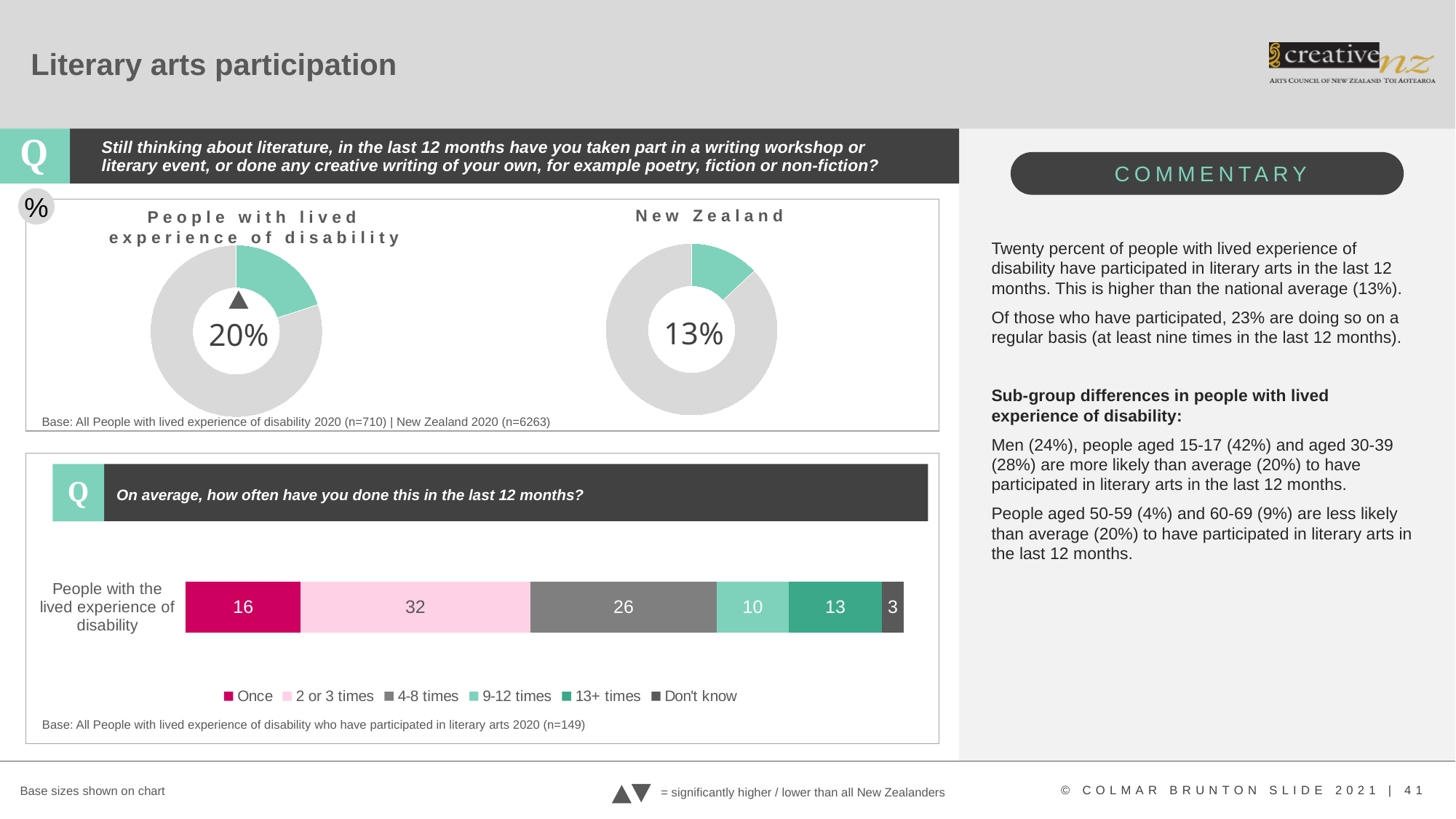
In the bottom stacked bar chart, what is the value for '2 or 3 times'? 32 Comparing the two donut charts at the top, which group has the higher participation value: people with lived experience of disability or New Zealand? People with lived experience of disability In the bottom stacked bar chart, which frequency category has the smallest value? Don't know In the top-left donut chart, what percentage of people with lived experience of disability have participated in literary arts? 20% What is the difference between the 20% shown in the left donut chart and the 13% shown in the right donut chart? 7 percentage points What is the total of all segments in the bottom stacked bar? 100 In the top-right donut chart, what is the participation value shown for New Zealand? 13% How many series does the legend of the bottom stacked bar chart list? 6 In the bottom stacked bar chart, what is the difference between the values for '2 or 3 times' and '4-8 times'? 6 In the bottom stacked bar chart, which frequency category has the largest value? 2 or 3 times What type of chart is used in the bottom panel of the slide? Stacked bar chart In the bottom stacked bar chart, what is the value for '13+ times'? 13